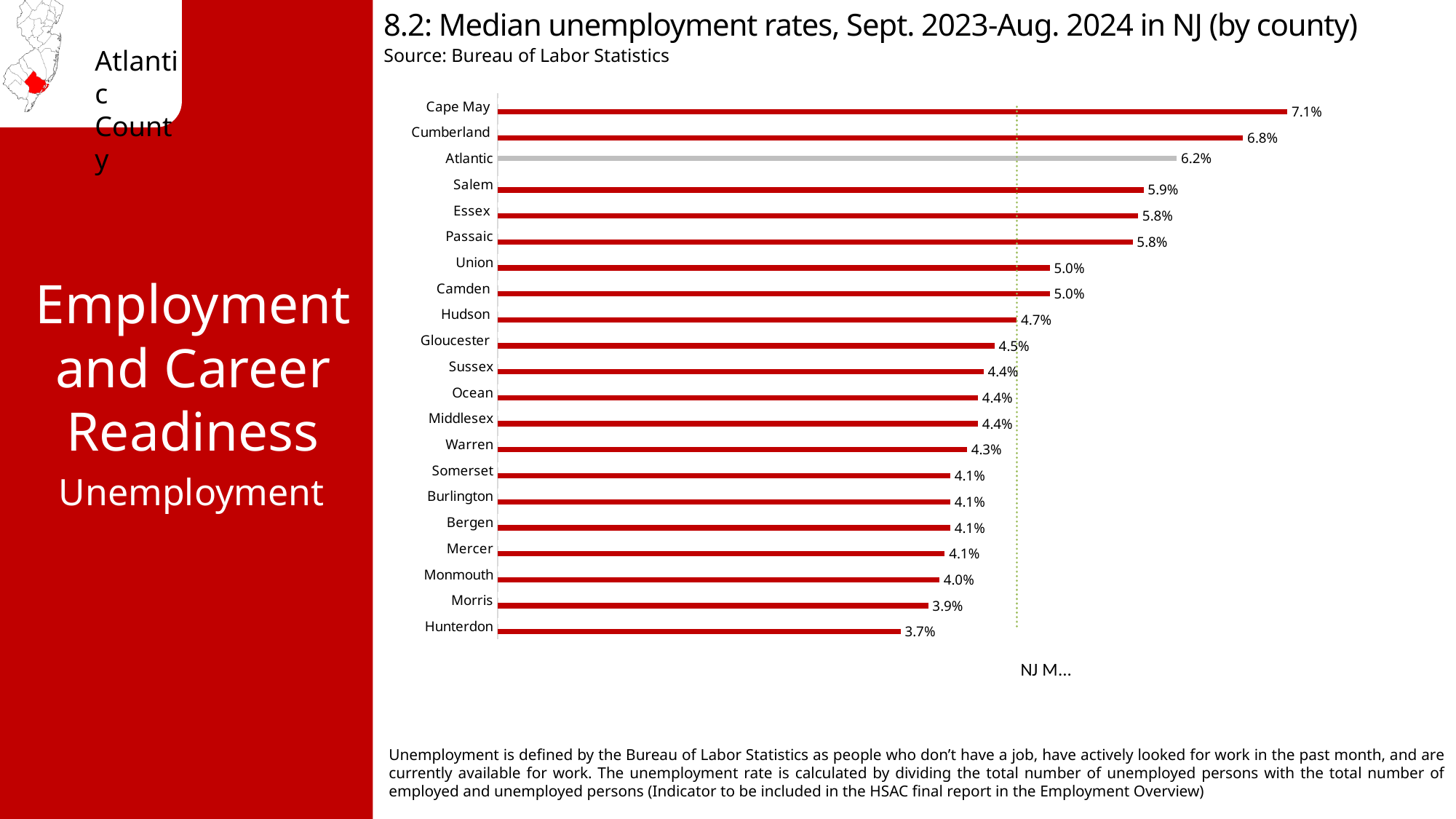
Which county's bar is shown in grey rather than red? Atlantic What is the median unemployment rate for Cumberland County? 6.8% Which county has the lowest median unemployment rate? Hunterdon Which has a higher median unemployment rate, Gloucester or Morris? Gloucester What is the difference between the median unemployment rates of Cape May and Hunterdon? 3.4% Which has a higher median unemployment rate, Cumberland or Atlantic? Cumberland What kind of chart is shown on the slide? Bar chart How many counties are shown in the chart? 21 Which county has the highest median unemployment rate? Cape May What is the median unemployment rate for Atlantic County? 6.2% What is the median unemployment rate for Hudson County? 4.7% What is the difference between the median unemployment rates of Atlantic and Salem? 0.3%